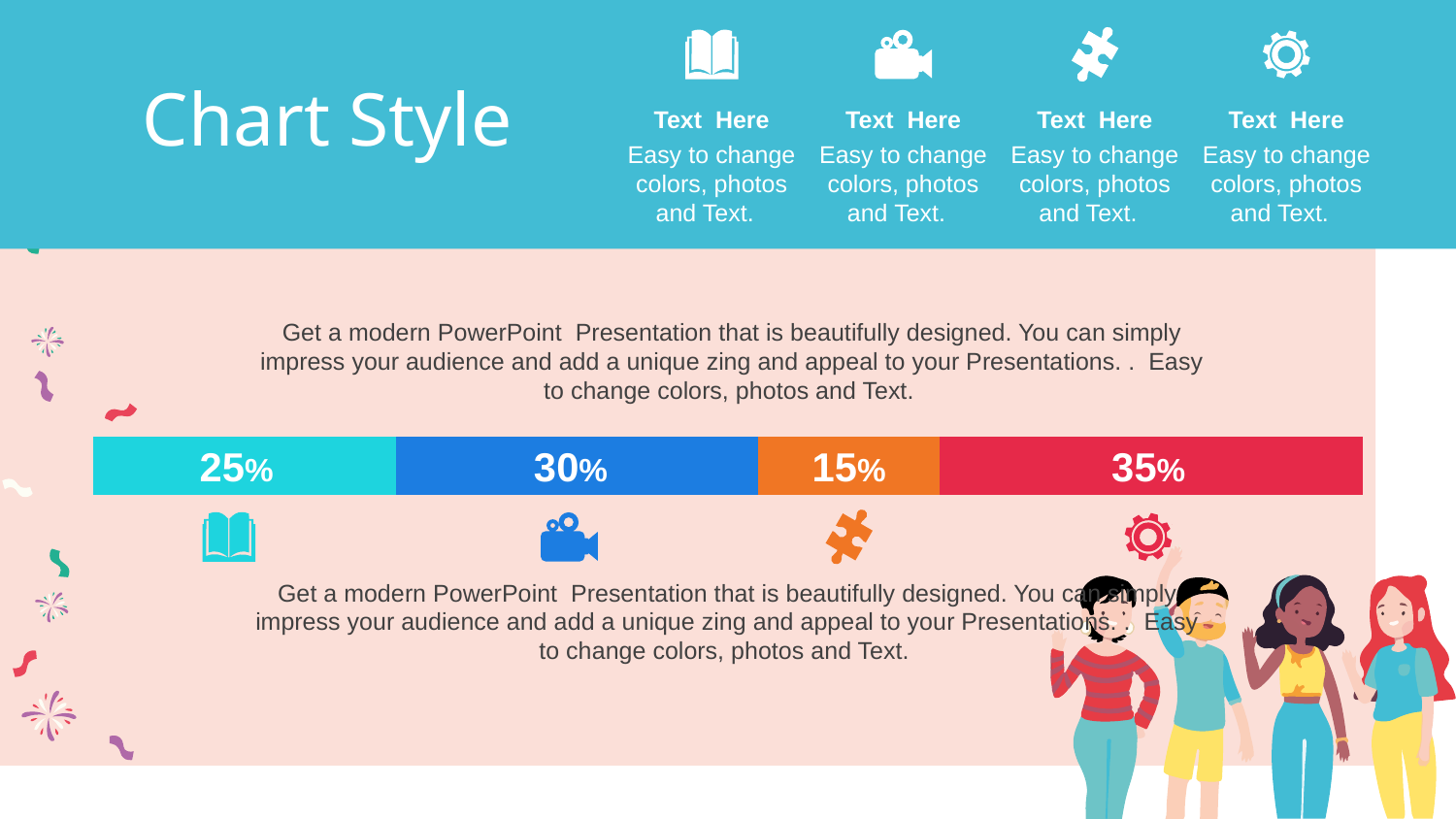
What is the difference between the red segment and the orange segment? 20% What is the value of the cyan (first) segment of the bar? 25% What is the value of the orange (third) segment of the bar? 15% Which segment of the bar has the highest value? the red segment (35%) Which icon appears below the orange segment of the bar? a puzzle piece What is the value of the red (fourth) segment of the bar? 35% Which is larger, the cyan segment or the blue segment? the blue segment (30%) What is the value of the blue (second) segment of the bar? 30% Which segment of the bar has the lowest value? the orange segment (15%) What is the total of all four segments of the stacked bar? 105% How many segments does the stacked bar contain? 4 What kind of chart is shown on the slide? bar chart